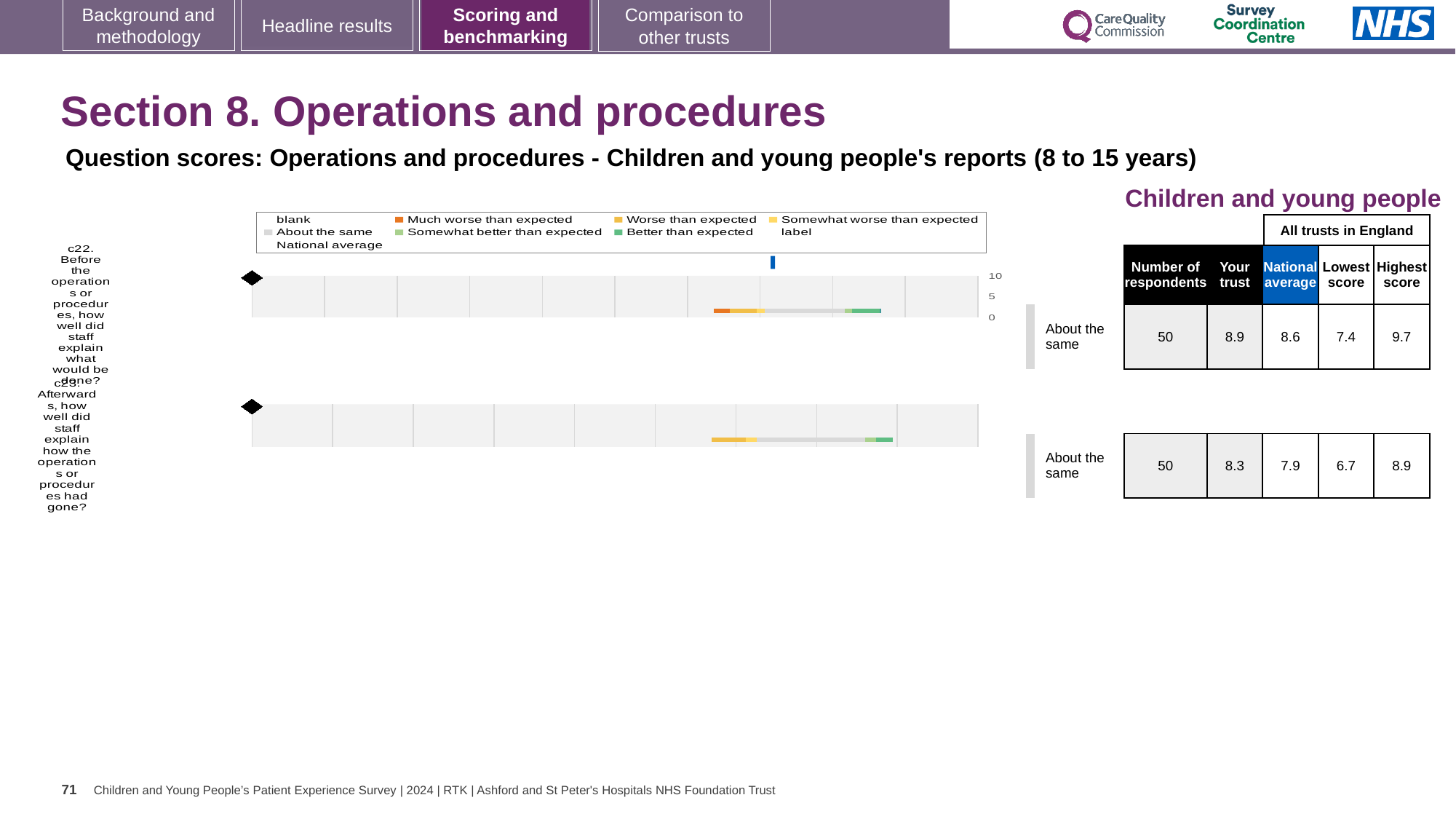
How many questions are charted on this slide? 2 For question c23 (Afterwards, how well did staff explain how the operations or procedures had gone?), what is the score for Your trust? 8.3 How many respondents answered question c22? 50 For question c22, what is the National average score? 8.6 For question c23, what is the difference between the Highest score and the Lowest score? 2.2 For question c23, what is the National average score? 7.9 For question c22, how much higher is Your trust score than the National average? 0.3 Which question has the higher Your trust score, c22 or c23? c22 For question c22 (Before the operations or procedures, how well did staff explain what would be done?), what is the score for Your trust? 8.9 For question c23, what is the Highest score among all trusts in England? 8.9 For question c22, what is the Lowest score among all trusts in England? 7.4 What benchmark category is shown for question c23? About the same